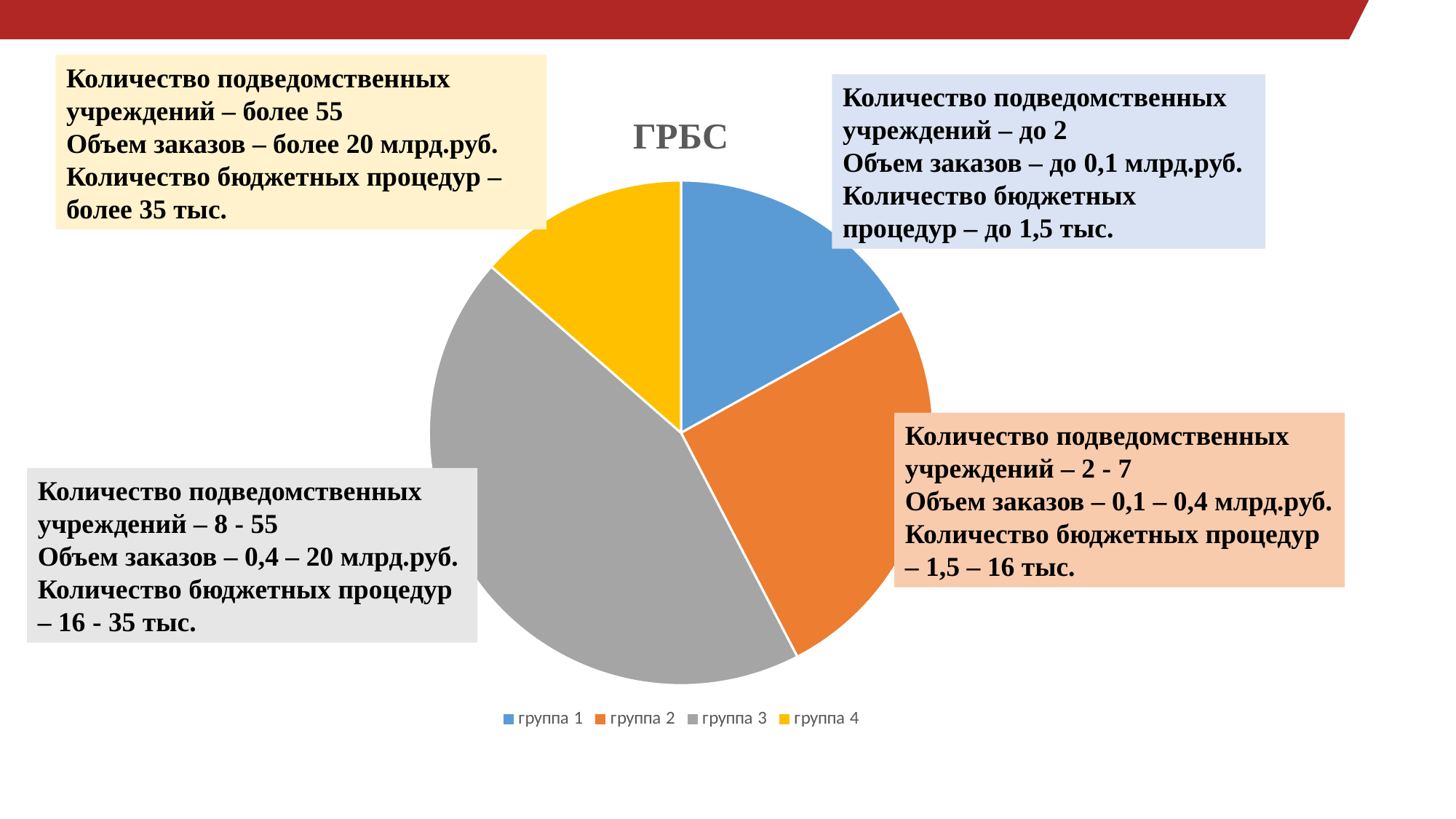
Which group has the largest slice of the pie chart? группа 3 What is the title of the pie chart? ГРБС Which slice is larger, группа 3 or группа 1? группа 3 Which group has the smallest slice of the pie chart? группа 4 How many entries does the legend of the pie chart list? 4 How many slices does the pie chart have? 4 Which slice is larger, группа 2 or группа 1? группа 2 Which slice is larger, группа 2 or группа 4? группа 2 What kind of chart is shown on the slide? pie chart What colour is the slice for группа 3 in the pie chart? gray